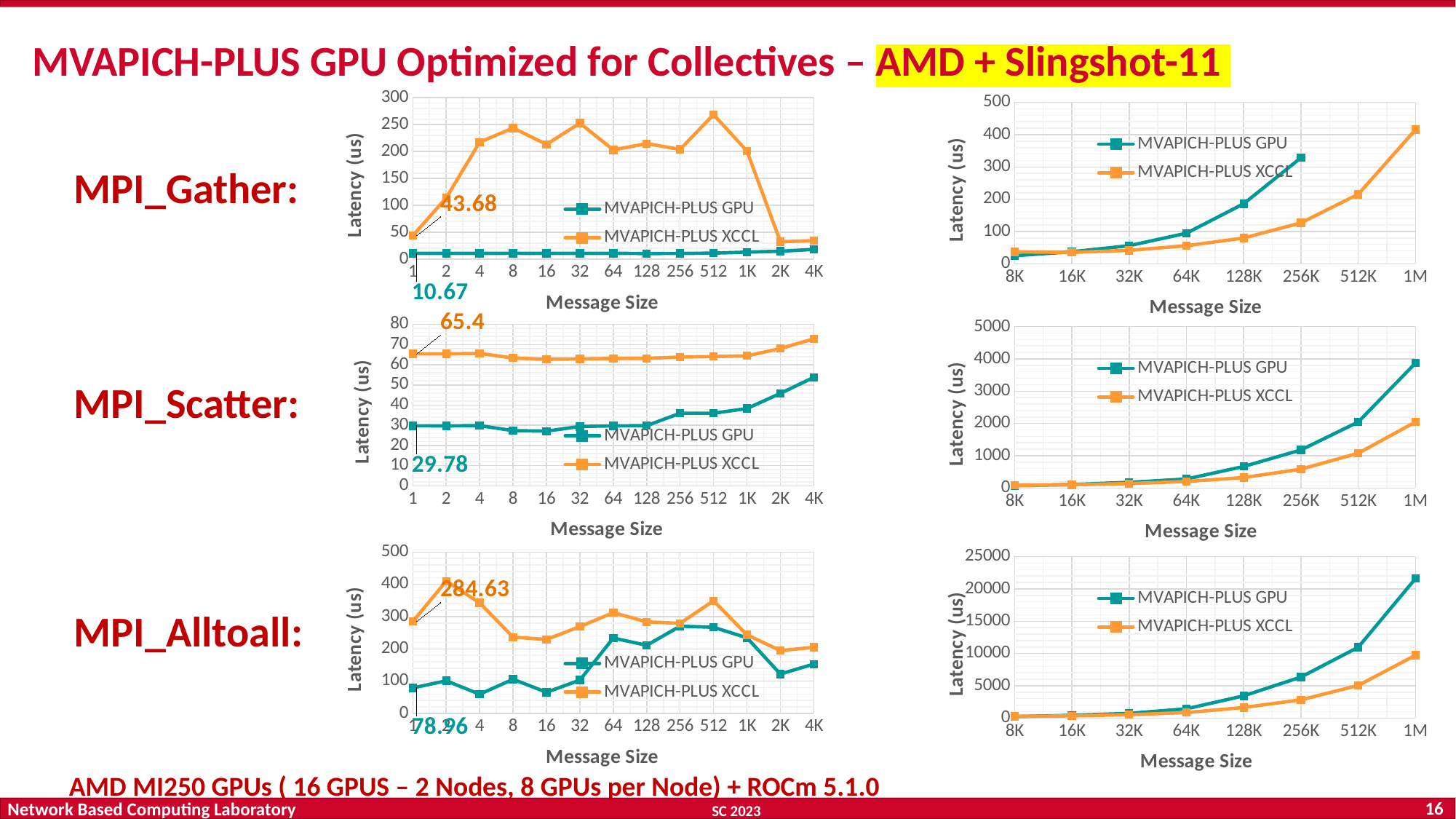
On the MPI_Scatter left chart (message sizes 1 to 4K), what is the labelled latency for MVAPICH-PLUS XCCL at message size 1? 65.4 On the MPI_Scatter left chart (message sizes 1 to 4K), what is the labelled latency for MVAPICH-PLUS GPU at message size 1? 29.78 How many message sizes are shown on the x axis of the MPI_Gather left chart (message sizes 1 to 4K)? 13 On the MPI_Alltoall left chart (message sizes 1 to 4K), what is the labelled latency for MVAPICH-PLUS XCCL at message size 1? 284.63 On the MPI_Gather left chart (message sizes 1 to 4K), what is the labelled latency for MVAPICH-PLUS XCCL at message size 1? 43.68 On the MPI_Alltoall right chart (message sizes 8K to 1M), does the MVAPICH-PLUS GPU latency rise or fall as message size increases? Rise How many series does the legend list on the MPI_Scatter right chart (message sizes 8K to 1M)? 2 On the MPI_Gather left chart (message sizes 1 to 4K), what is the labelled latency for MVAPICH-PLUS GPU at message size 1? 10.67 On the MPI_Alltoall left chart, what is the difference between the labelled latencies of MVAPICH-PLUS XCCL and MVAPICH-PLUS GPU at message size 1? 205.67 On the MPI_Gather left chart, what is the difference between the labelled latencies of MVAPICH-PLUS XCCL and MVAPICH-PLUS GPU at message size 1? 33.01 What kind of chart is the MPI_Alltoall right chart (message sizes 8K to 1M)? Line chart On the MPI_Alltoall left chart (message sizes 1 to 4K), what is the labelled latency for MVAPICH-PLUS GPU at message size 1? 78.96